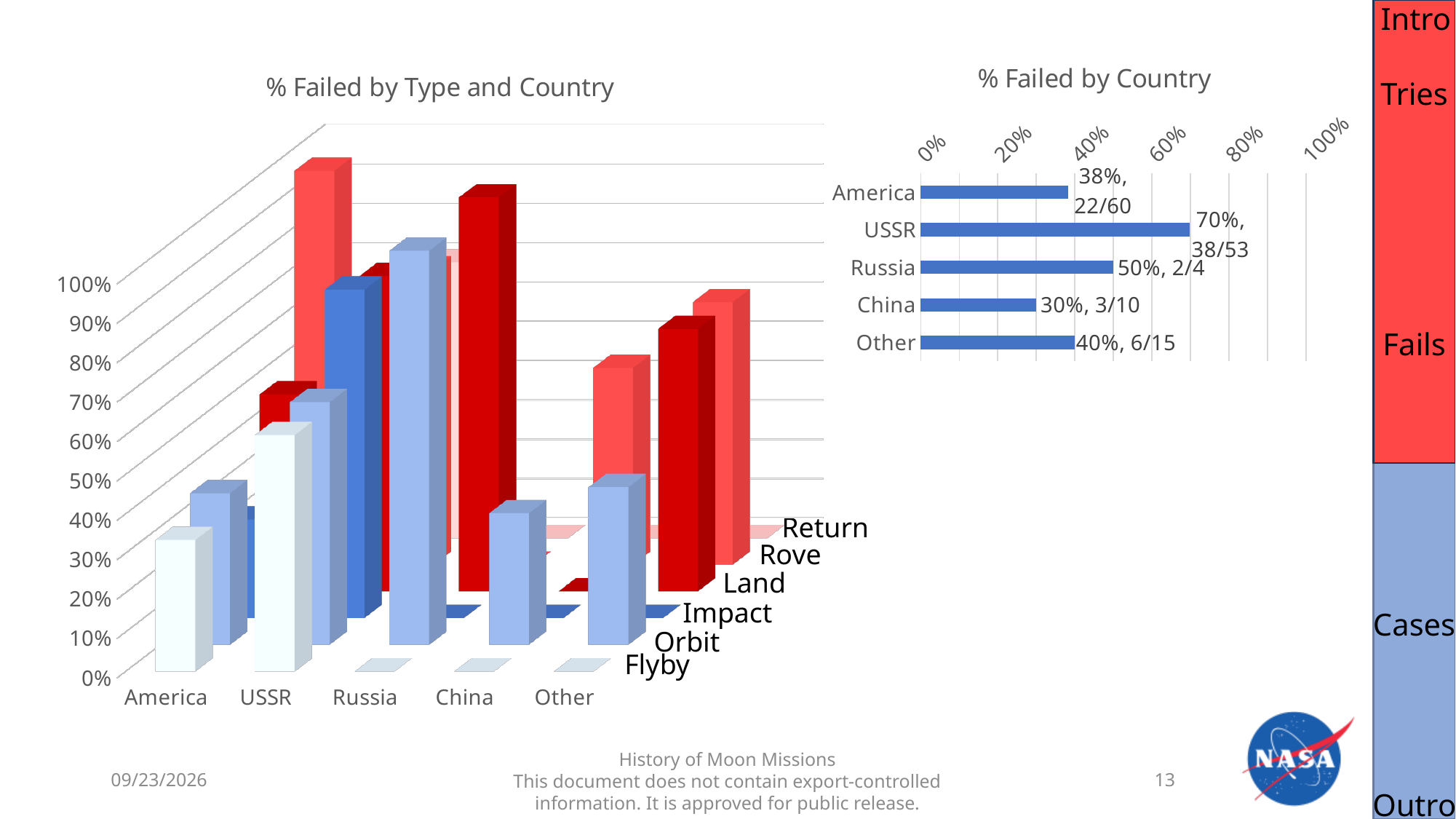
In the '% Failed by Country' chart, which is larger, the value for Other or the value for America? Other In the '% Failed by Country' chart, what fraction is shown next to America's bar? 22/60 In the '% Failed by Country' chart, what is the difference between the USSR and Russia percentages? 20% In the '% Failed by Country' chart, which country has the lowest failure percentage? China In the '% Failed by Country' chart, what is the value for USSR? 70% What is the title of the chart on the left side of the slide? % Failed by Type and Country In the '% Failed by Country' chart, is the value for Russia greater or less than 40%? greater How many mission types are listed along the depth axis of the '% Failed by Type and Country' chart? 6 In the '% Failed by Country' chart, which country has the highest failure percentage? USSR In the '% Failed by Country' chart, what is the value for China? 30% How many countries are shown in the '% Failed by Country' chart? 5 What kind of chart is the '% Failed by Country' chart? Bar chart